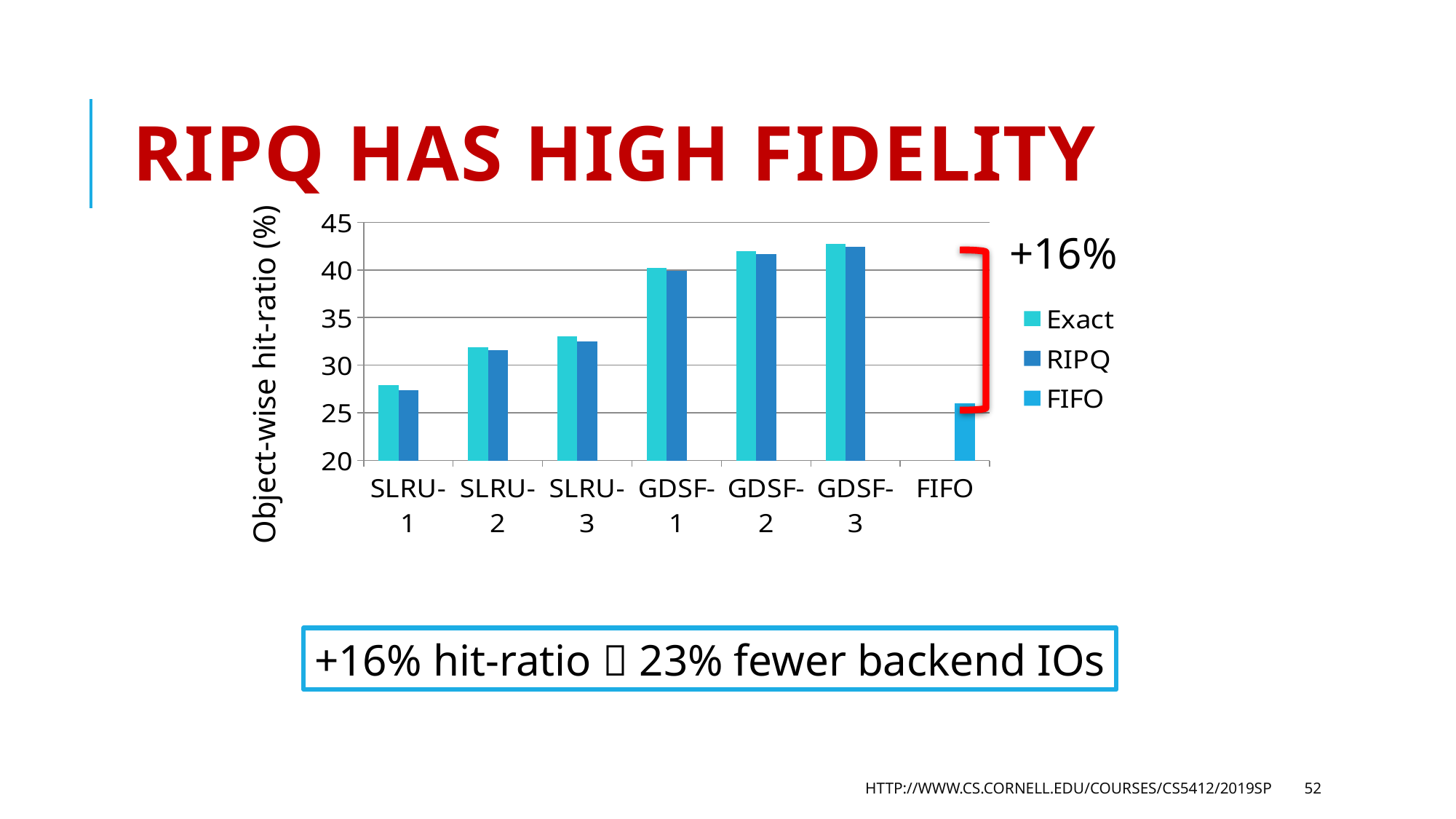
Is the Exact value for SLRU-3 greater or less than 35? less Which category has the highest Exact value? GDSF-3 Is the Exact value for SLRU-1 greater or less than 30? less Is the Exact value for GDSF-2 greater or less than 40? greater Which is larger, the Exact value for GDSF-1 or the Exact value for SLRU-3? GDSF-1 How many categories are shown along the x axis of the chart? 7 What is the label on the y axis of the chart? Object-wise hit-ratio (%) Which category has the lowest RIPQ value? SLRU-1 What kind of chart is shown on the slide? bar chart Do the RIPQ values rise or fall from SLRU-1 to GDSF-3? rise How many series does the chart legend list? 3